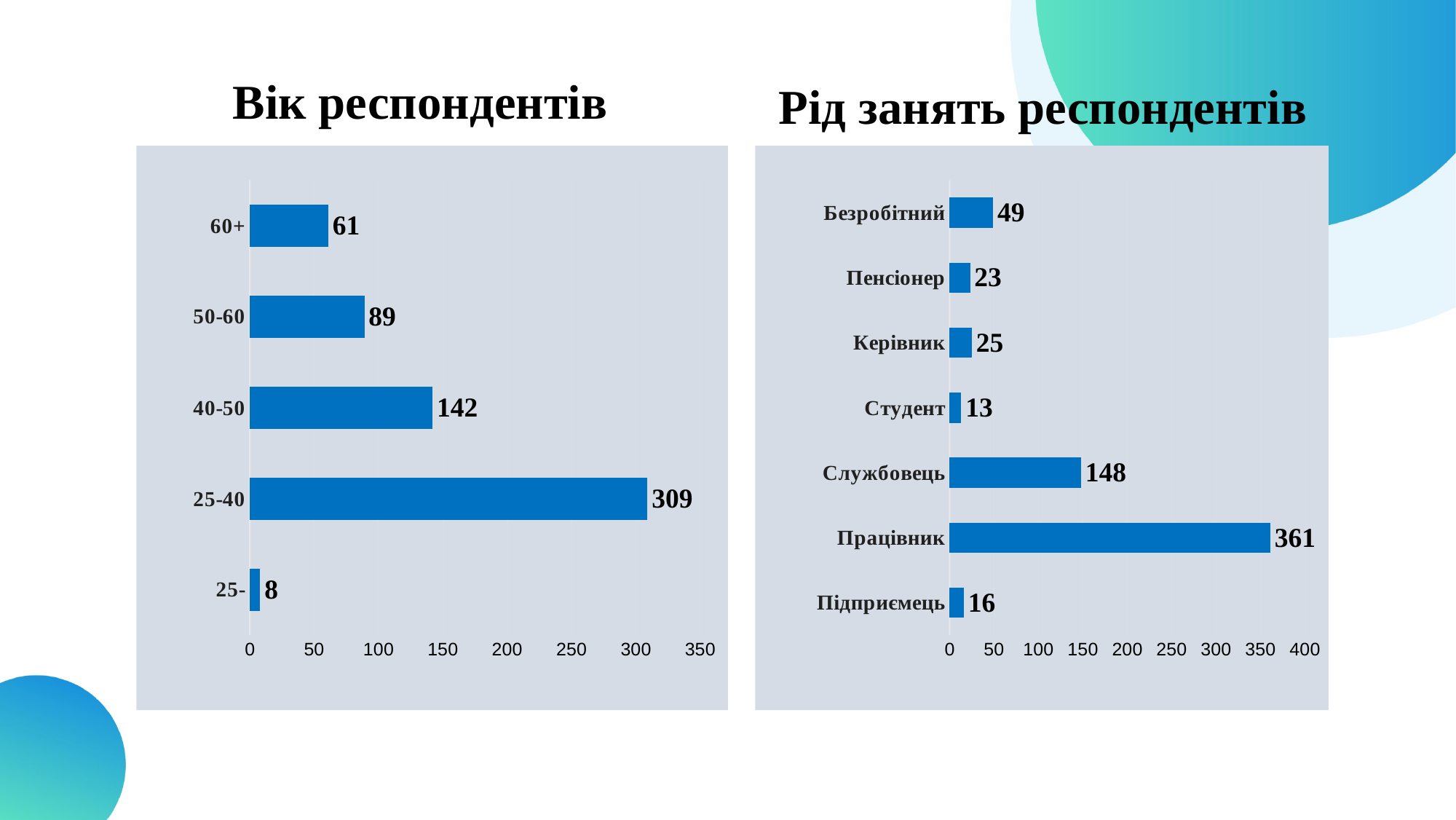
In the 'Вік респондентів' chart, what is the value for the 25-40 category? 309 In the 'Рід занять респондентів' chart, how many categories are shown? 7 In the 'Вік респондентів' chart, which category has the lowest value? 25- What kind of chart is 'Вік респондентів'? Bar chart In the 'Рід занять респондентів' chart, which category has the highest value? Працівник In the 'Рід занять респондентів' chart, which is larger: the value for Безробітний or the value for Керівник? Безробітний In the 'Рід занять респондентів' chart, what is the value for Пенсіонер? 23 In the 'Рід занять респондентів' chart, which category has the lowest value? Студент In the 'Рід занять респондентів' chart, what is the value for Службовець? 148 In the 'Вік респондентів' chart, what is the difference between the values for 40-50 and 60+? 81 In the 'Вік респондентів' chart, what is the value for the 50-60 category? 89 In the 'Вік респондентів' chart, how many age categories are shown? 5